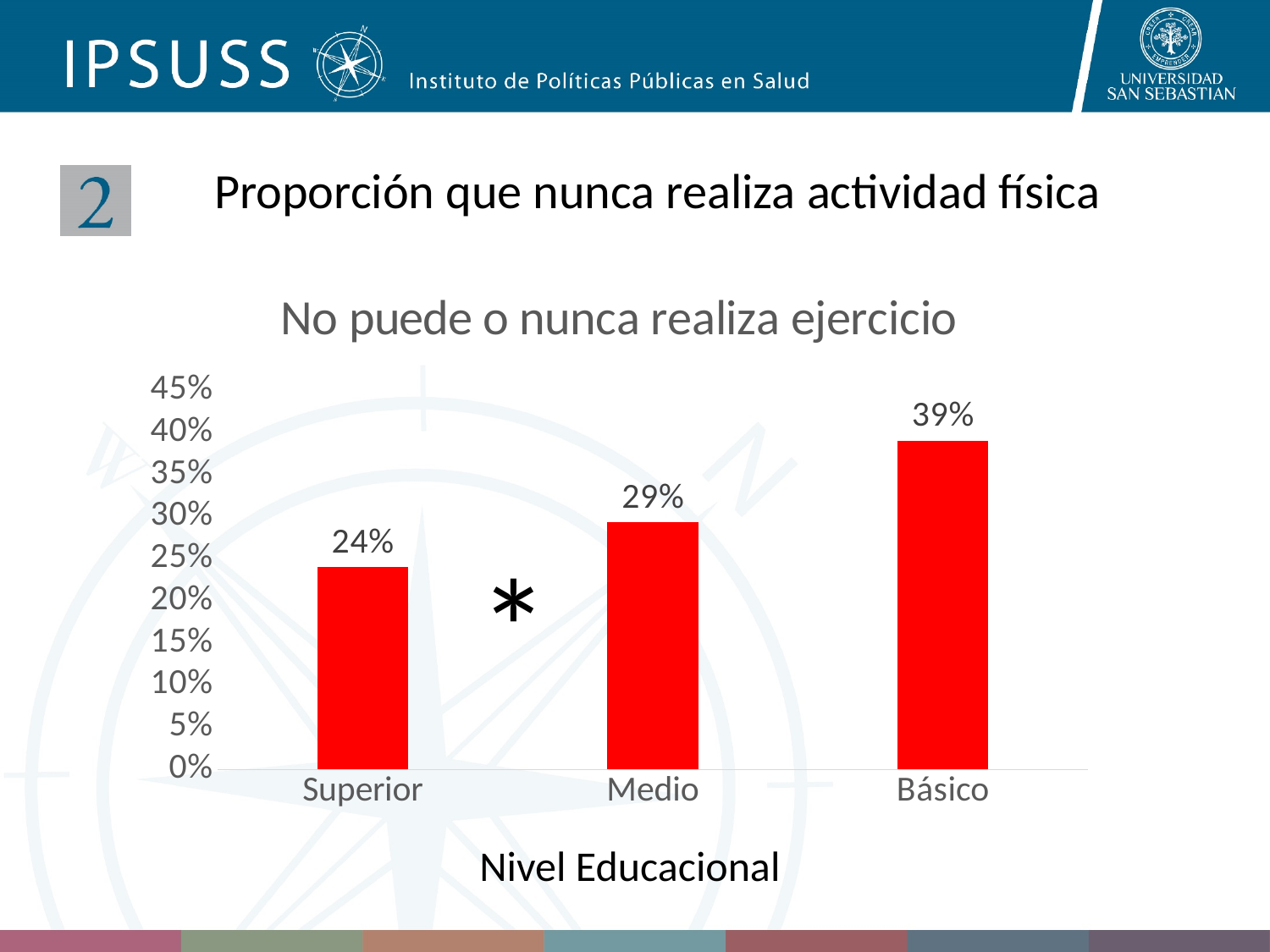
Which educational level has the lowest value? Superior How many categories are shown on the x axis? 3 What kind of chart is shown? bar chart What is the value for Básico? 39% Which educational level has the highest value? Básico What is the value for Medio? 29% Which is larger, the value for Medio or the value for Básico? Básico What is the difference between the values for Básico and Superior? 15% What is the difference between the values for Medio and Superior? 5% Do the values rise or fall from Superior to Básico? rise What is the value for Superior? 24% Is the value for Básico greater or less than 35%? greater